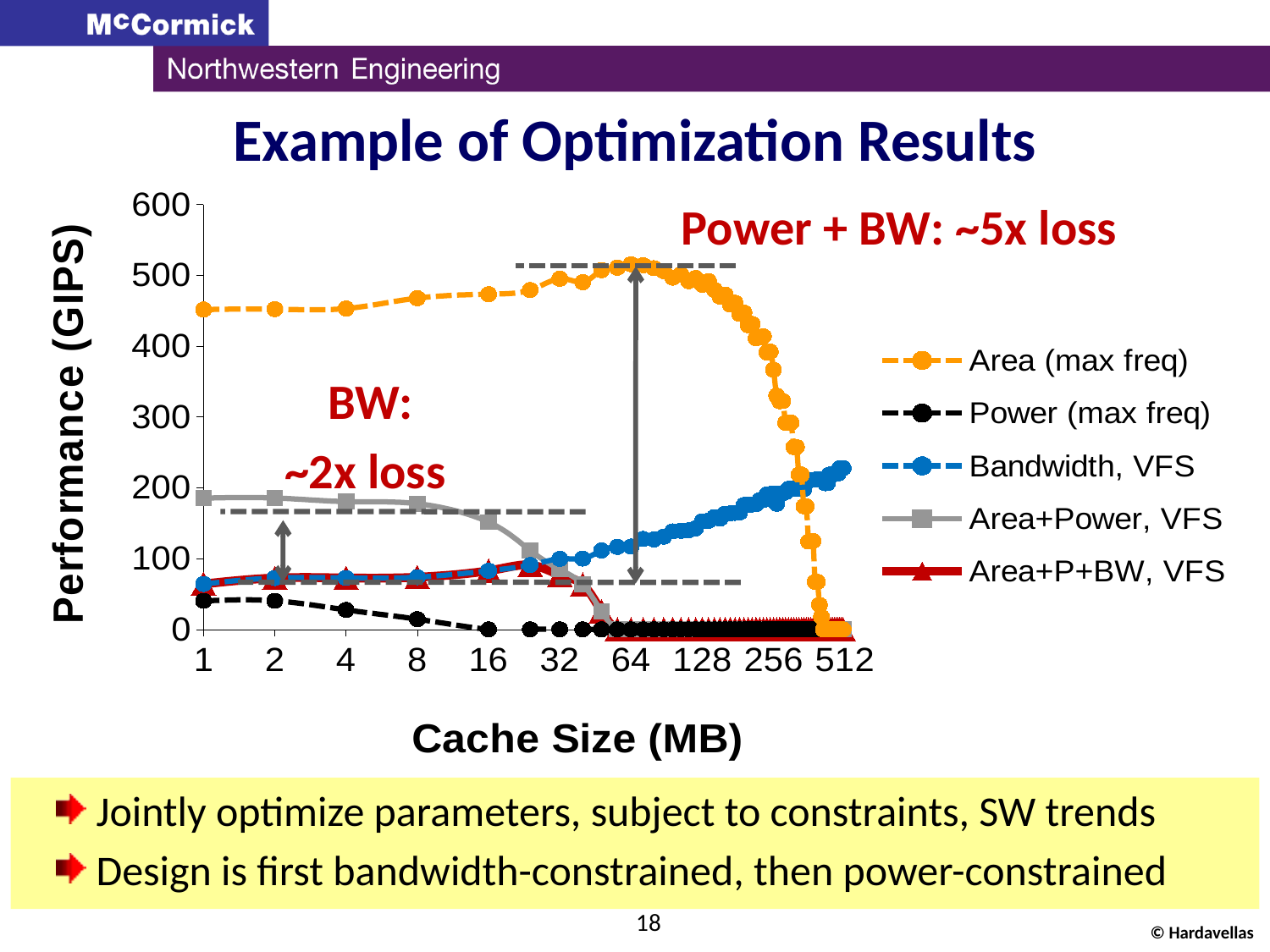
Which series has the lowest value at cache size 1 MB? Power (max freq) Which series has the highest value at cache size 1 MB? Area (max freq) What is the label of the x axis? Cache Size (MB) What is the label of the y axis? Performance (GIPS) What kind of chart is shown on the slide? line chart Is the value for Power (max freq) at cache size 1 MB greater or less than 100? less Is the value for Area (max freq) at cache size 1 MB greater or less than 400? greater Is the value for Area+Power, VFS at cache size 1 MB greater or less than 100? greater How many series does the legend list? 5 Does the Power (max freq) series rise or fall as cache size increases? fall Does the Bandwidth, VFS series rise or fall as cache size increases? rise